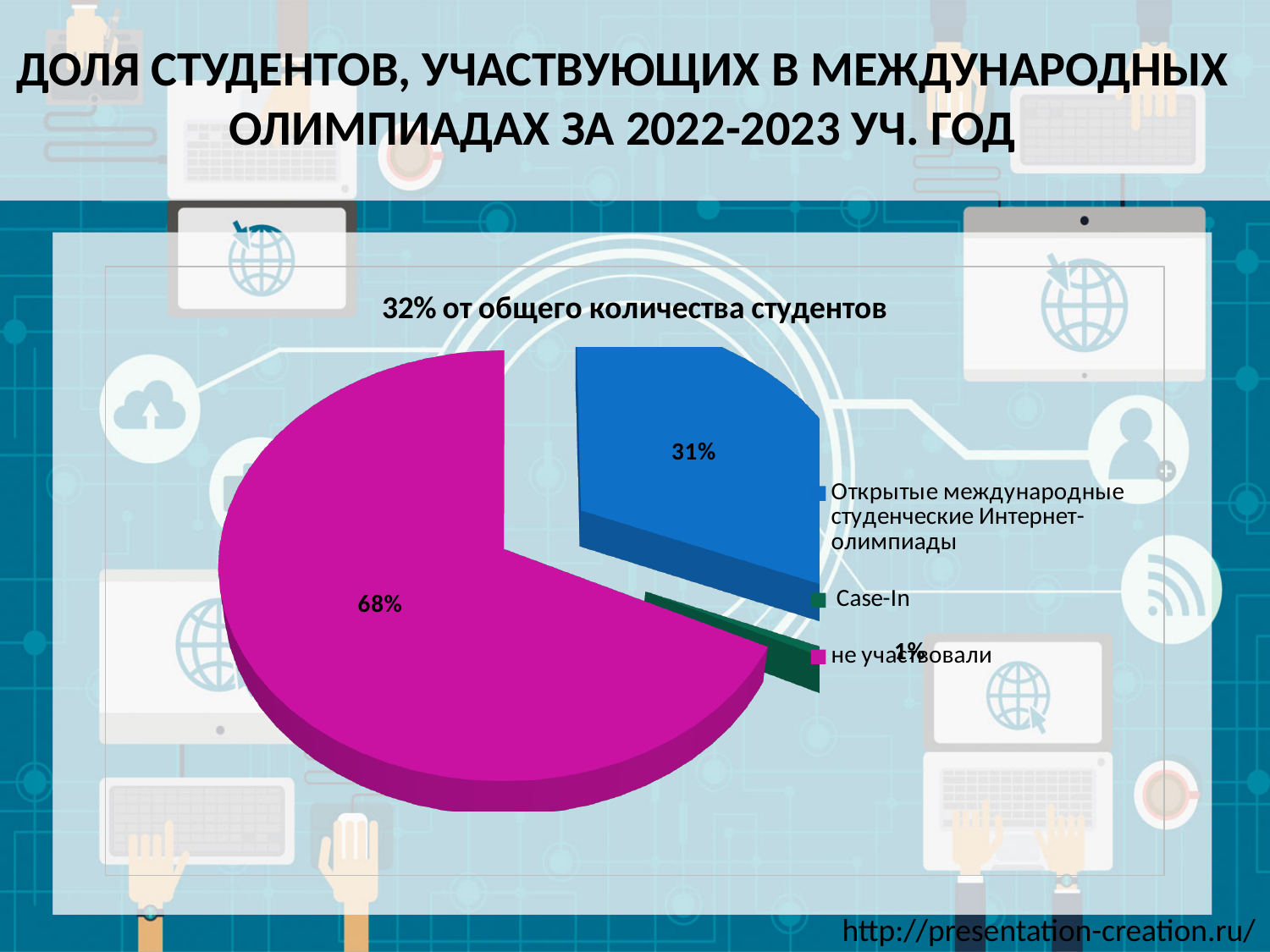
What share of the pie is labelled "не участвовали"? 68% How many slices does the pie chart have? 3 What share of the pie is labelled "Открытые международные студенческие Интернет-олимпиады"? 31% What kind of chart is shown on the slide? pie chart What is the difference between the "не участвовали" share and the "Открытые международные студенческие Интернет-олимпиады" share? 37% Which category has the smallest slice of the pie? Case-In What share of the pie is labelled "Case-In"? 1% What is the combined share of the two participating categories ("Открытые международные студенческие Интернет-олимпиады" and "Case-In")? 32% Which is larger: the share for "Открытые международные студенческие Интернет-олимпиады" or the share for "Case-In"? Открытые международные студенческие Интернет-олимпиады Which category has the largest slice of the pie? не участвовали What is the title of the chart? 32% от общего количества студентов What colour is the "не участвовали" slice? magenta